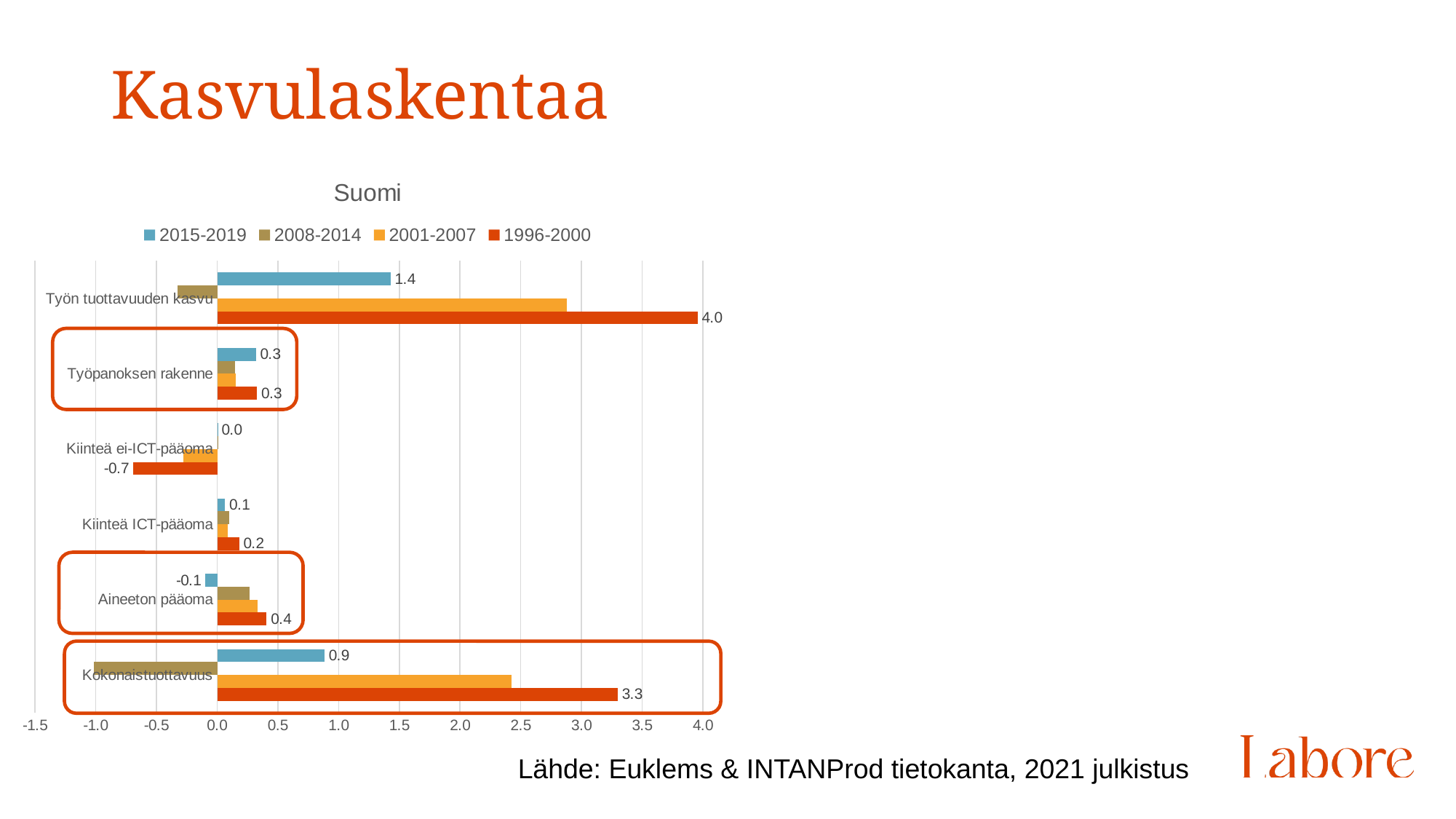
How many series does the legend of the Suomi chart list? 4 In the Suomi chart, what is the value for Työn tuottavuuden kasvu in the 1996-2000 series? 4.0 In the Suomi chart, which category has the highest value in the 1996-2000 series? Työn tuottavuuden kasvu In the Suomi chart, is the 2015-2019 value larger for Työn tuottavuuden kasvu or for Kokonaistuottavuus? Työn tuottavuuden kasvu In the Suomi chart, what is the value for Aineeton pääoma in the 2015-2019 series? -0.1 In the Suomi chart, what is the value for Kiinteä ei-ICT-pääoma in the 1996-2000 series? -0.7 How many categories are shown in the Suomi chart? 6 In the Suomi chart, what is the difference between the 1996-2000 and 2015-2019 values for Kokonaistuottavuus? 2.4 In the Suomi chart, is the 2001-2007 value for Työn tuottavuuden kasvu greater or less than 2.5? greater In the Suomi chart, which category has the lowest value in the 1996-2000 series? Kiinteä ei-ICT-pääoma In the Suomi chart, what is the value for Kokonaistuottavuus in the 2015-2019 series? 0.9 In the Suomi chart, what is the difference between the 1996-2000 and 2015-2019 values for Työn tuottavuuden kasvu? 2.6